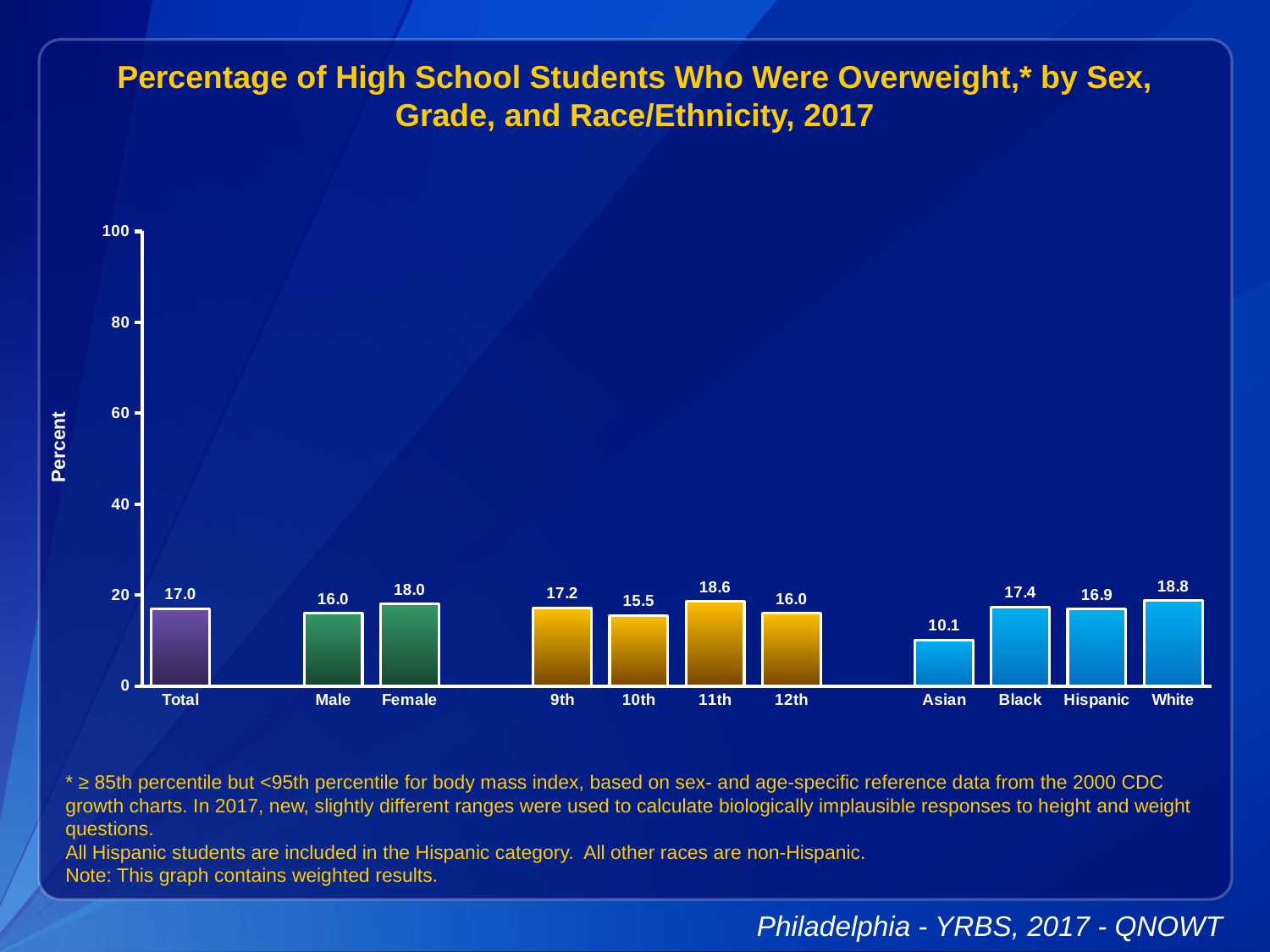
Which category has the lowest value? Asian What is the difference between the Female and Male values? 2.0 What is the difference between the White and Asian values? 8.7 What is the value for Total? 17.0 What is the value for 11th grade? 18.6 Which is larger, the value for 9th grade or 10th grade? 9th What is the label of the y axis? Percent Is the value for Black greater or less than 20? less Which category has the highest value? White What kind of chart is this? bar chart How many categories are shown on the x axis? 11 What is the value for Asian? 10.1